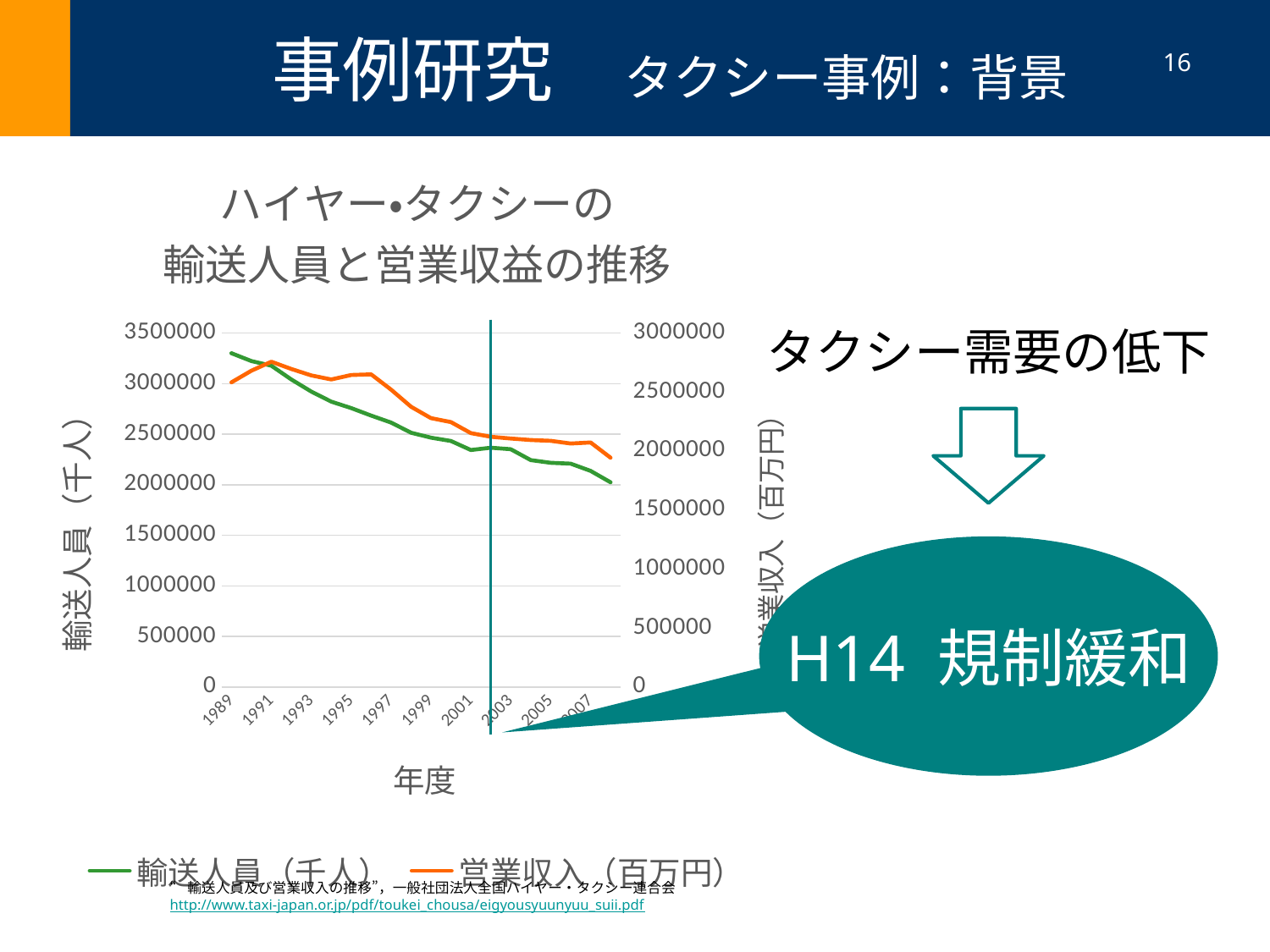
How many series does the chart legend list? 2 Does the 輸送人員（千人） series rise or fall from 1989 to 2007? fall What kind of chart is shown on the slide? line chart What is the label of the x axis of the chart? 年度 Is the value for 輸送人員（千人） in 2001 greater or less than 2500000 on the left axis? less What is the title of the chart? ハイヤー•タクシーの輸送人員と営業収益の推移 Is the value for 輸送人員（千人） in 1995 greater or less than 2500000 on the left axis? greater Does the 営業収入（百万円） series rise or fall overall from 1989 to 2007? fall In which year is the 輸送人員（千人） series at its highest? 1989 Is the value for 輸送人員（千人） in 1989 greater or less than 3000000 on the left axis? greater Which series is drawn in green in the chart? 輸送人員（千人）